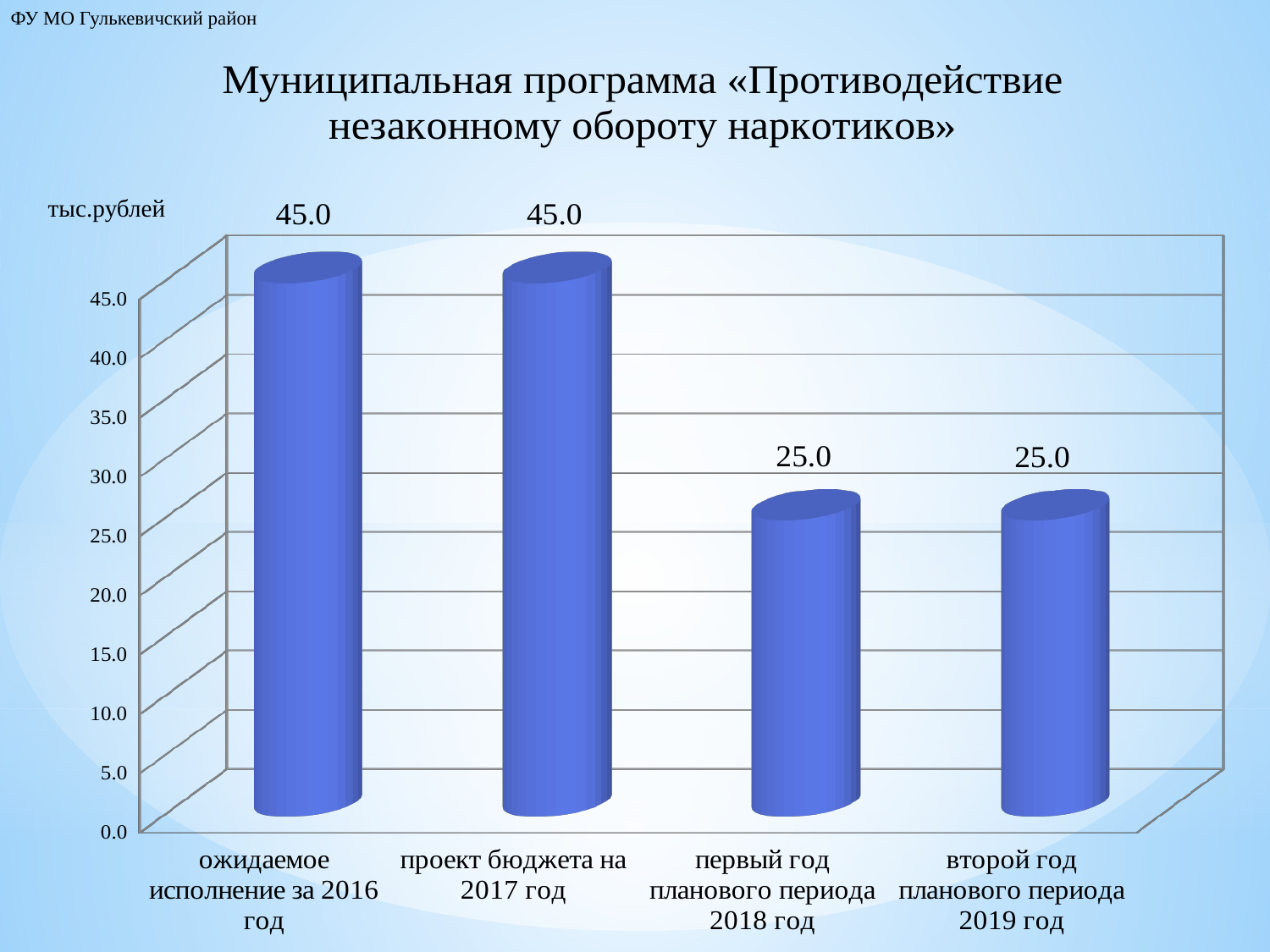
What is the value for «первый год планового периода 2018 год»? 25.0 What is the value for «проект бюджета на 2017 год»? 45.0 Is the value for «первый год планового периода 2018 год» greater or less than 30.0? less Do the values rise or fall from «проект бюджета на 2017 год» to «первый год планового периода 2018 год»? fall Which is larger: the value for «проект бюджета на 2017 год» or the value for «второй год планового периода 2019 год»? проект бюджета на 2017 год How many categories are shown on the chart? 4 What unit of measurement is indicated above the chart's vertical axis? тыс.рублей What is the value for «второй год планового периода 2019 год»? 25.0 What kind of chart is shown on the slide? bar chart What is the value for «ожидаемое исполнение за 2016 год»? 45.0 Is the value for «ожидаемое исполнение за 2016 год» greater or less than 40.0? greater What is the difference between the value for «проект бюджета на 2017 год» and the value for «первый год планового периода 2018 год»? 20.0